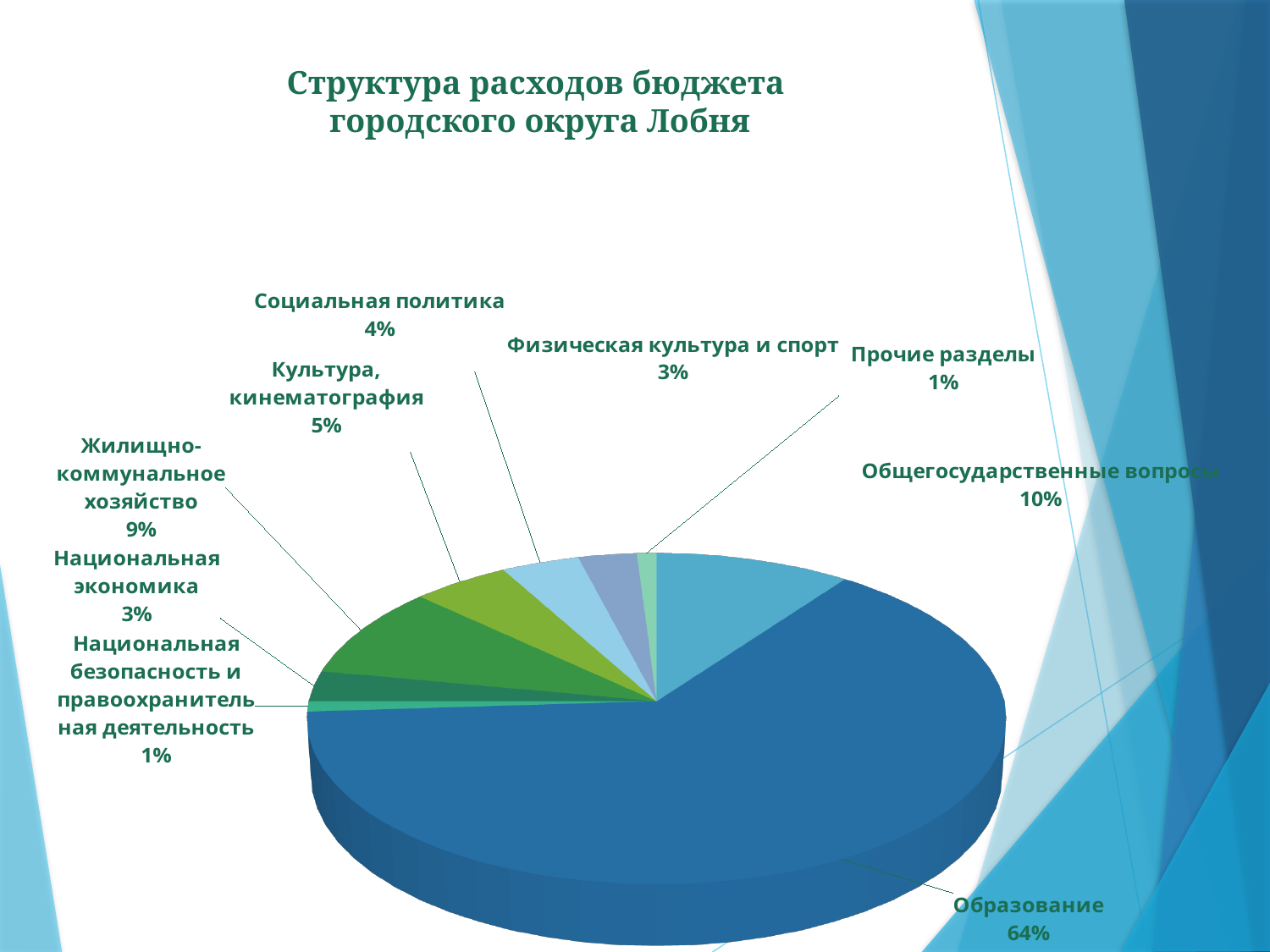
What is the combined share of Физическая культура и спорт and Национальная экономика? 6% What share of the budget expenditure goes to Образование? 64% What percentage is shown for Общегосударственные вопросы? 10% What is the difference in percentage points between Образование and Общегосударственные вопросы? 54 What percentage is shown for Социальная политика? 4% What is the title of the chart? Структура расходов бюджета городского округа Лобня What percentage is shown for Культура, кинематография? 5% How many categories (slices) does the pie chart have? 9 Which is larger, the share for Жилищно-коммунальное хозяйство or the share for Культура, кинематография? Жилищно-коммунальное хозяйство What percentage is shown for Жилищно-коммунальное хозяйство? 9% Which category has the largest share of the pie? Образование What type of chart is shown on the slide? Pie chart